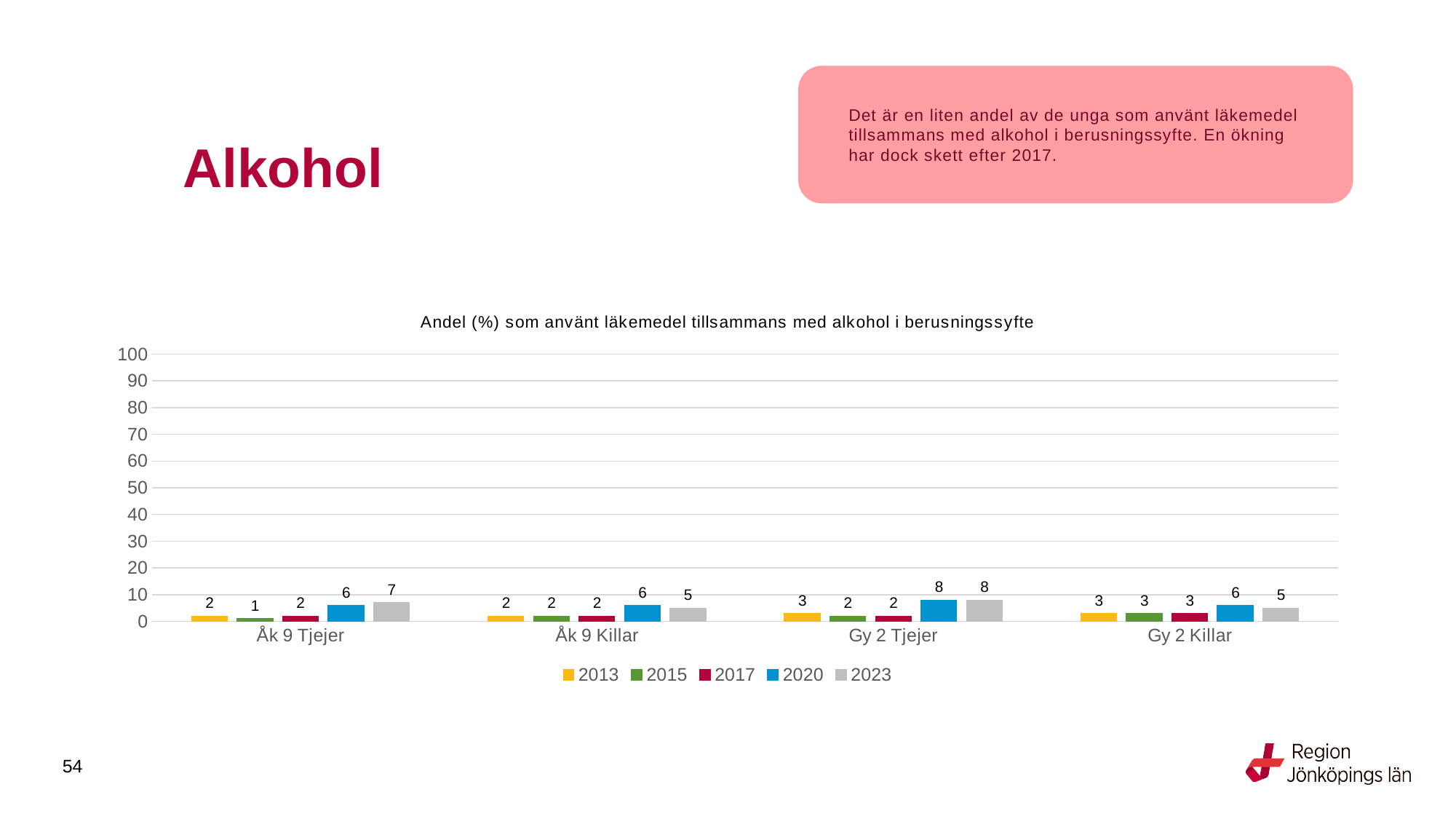
What is the value for 2015 in the Åk 9 Tjejer group? 1 Which year has the highest value in the Åk 9 Tjejer group? 2023 What is the title of the chart? Andel (%) som använt läkemedel tillsammans med alkohol i berusningssyfte How many groups are shown on the x axis? 4 How many series does the legend list? 5 What is the value for 2023 in the Åk 9 Tjejer group? 7 What kind of chart is shown on the slide? Bar chart What is the value for 2020 in the Gy 2 Tjejer group? 8 What is the value for 2013 in the Gy 2 Killar group? 3 What is the difference between the 2020 and 2017 values in the Gy 2 Tjejer group? 6 Which year has the lowest value in the Åk 9 Tjejer group? 2015 Which is larger in the Åk 9 Killar group, the 2020 value or the 2023 value? 2020